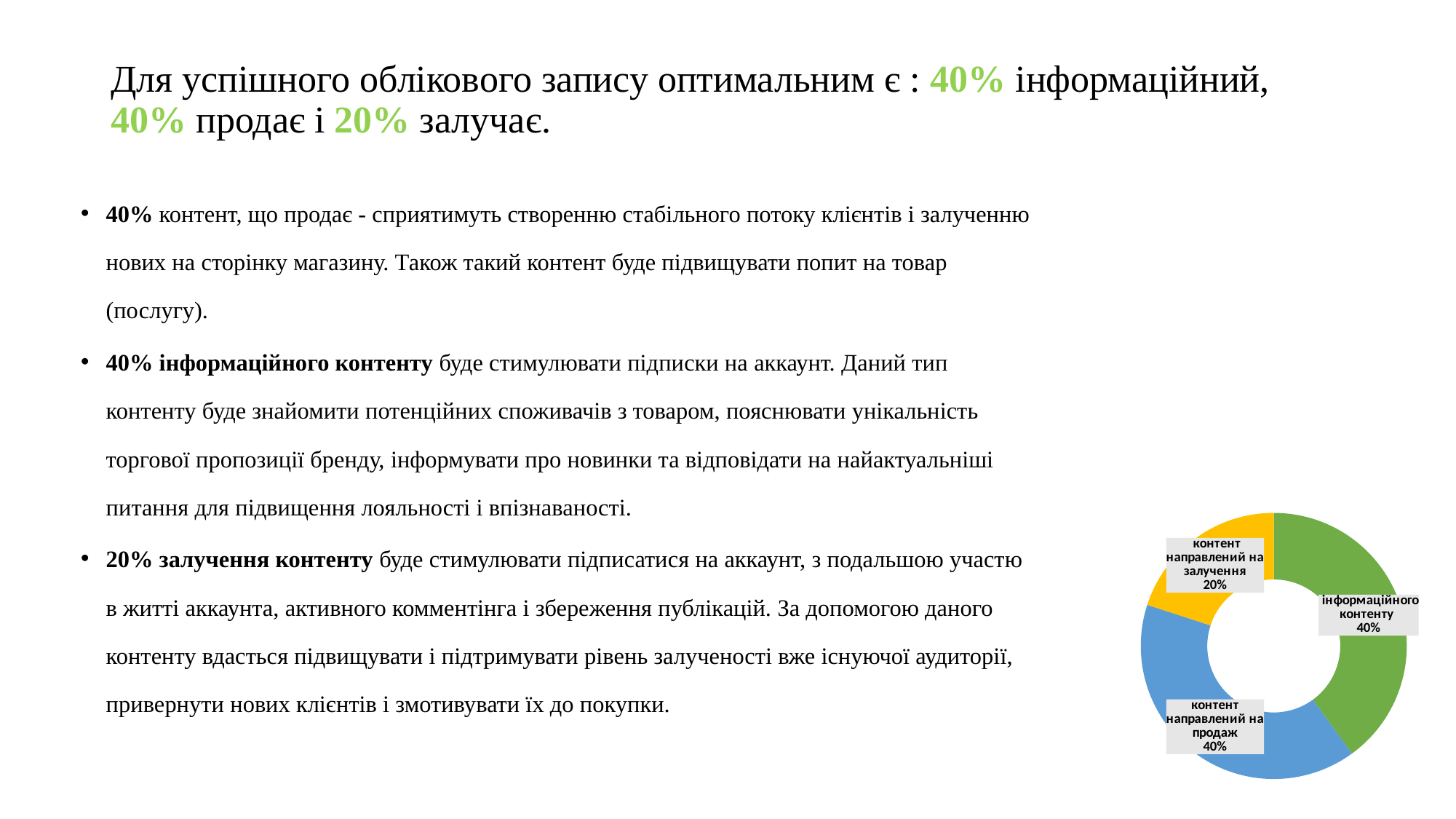
How many slices does the chart have? 3 Which category has the smallest slice in the chart? контент направлений на залучення What percentage is shown for "контент направлений на залучення" in the chart? 20% What colour is the slice for "контент направлений на залучення"? Yellow Which is larger in the chart: the slice for "інформаційного контенту" or the slice for "контент направлений на залучення"? інформаційного контенту What is the combined share of the two 40% slices in the chart? 80% What colour is the slice for "інформаційного контенту"? Green What percentage is shown for "контент направлений на продаж" in the chart? 40% What share of the doughnut chart is labelled "інформаційного контенту"? 40% What kind of chart is shown on the slide? Doughnut (pie) chart By how many percentage points does the "контент направлений на продаж" slice exceed the "контент направлений на залучення" slice? 20 percentage points